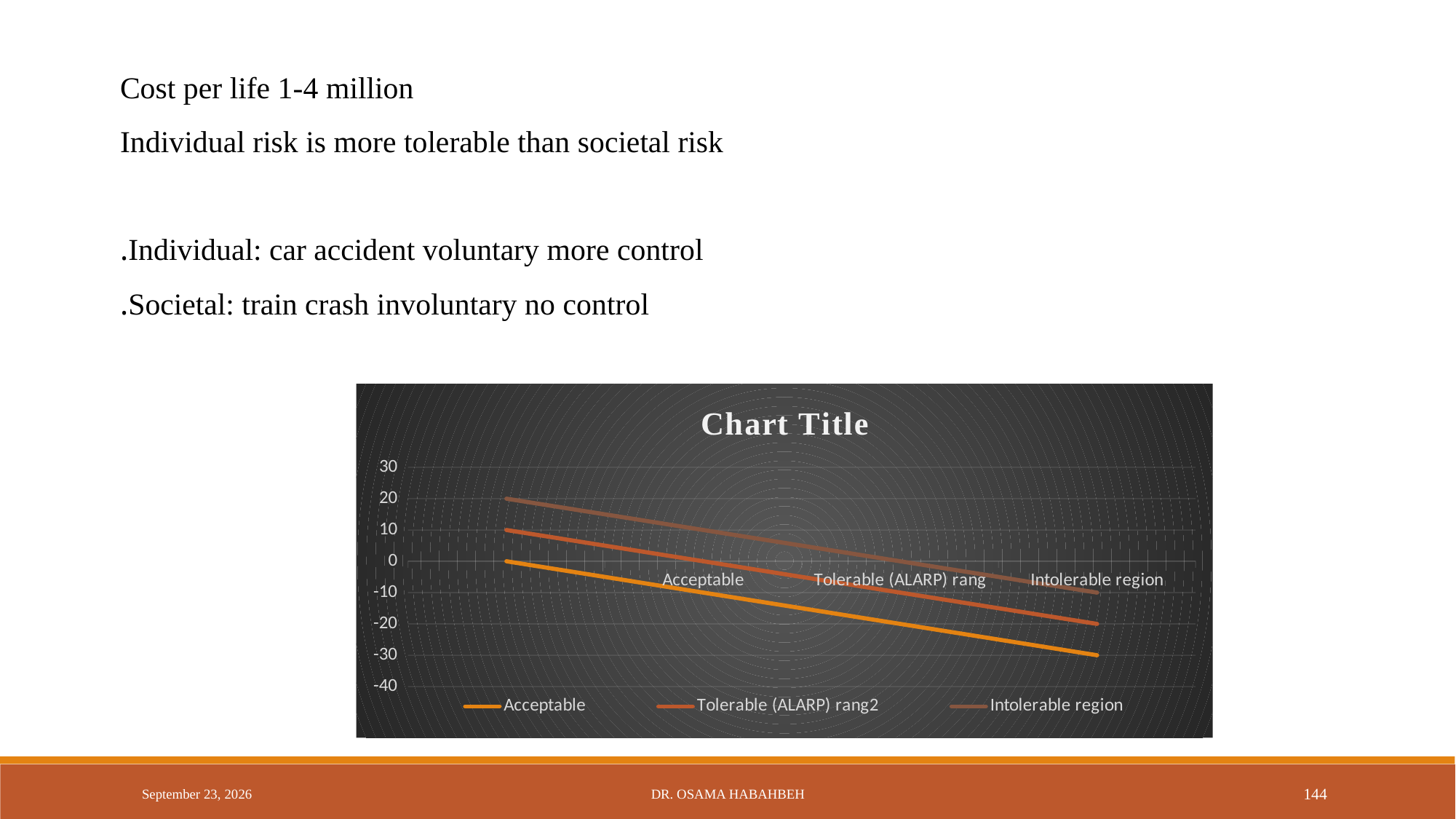
How many categories are shown on the x axis of the chart? 3 What is the value of the Acceptable series at the rightmost point (Intolerable region)? -30 Which series has the highest value at the leftmost point of the chart? Intolerable region Do the values of the Acceptable series rise or fall from left to right along the x axis? fall What kind of chart is shown on the slide? line chart Which series has the lowest value at the rightmost point (Intolerable region)? Acceptable What is the value of the Intolerable region series at the leftmost point of the chart? 20 What is the title of the chart? Chart Title What is the difference between the Acceptable series' leftmost value and its rightmost value? 30 At the rightmost point (Intolerable region), which series has the higher value: Acceptable or Intolerable region? Intolerable region What is the value of the Tolerable (ALARP) rang2 series at the rightmost point (Intolerable region)? -20 How many series does the chart legend list? 3